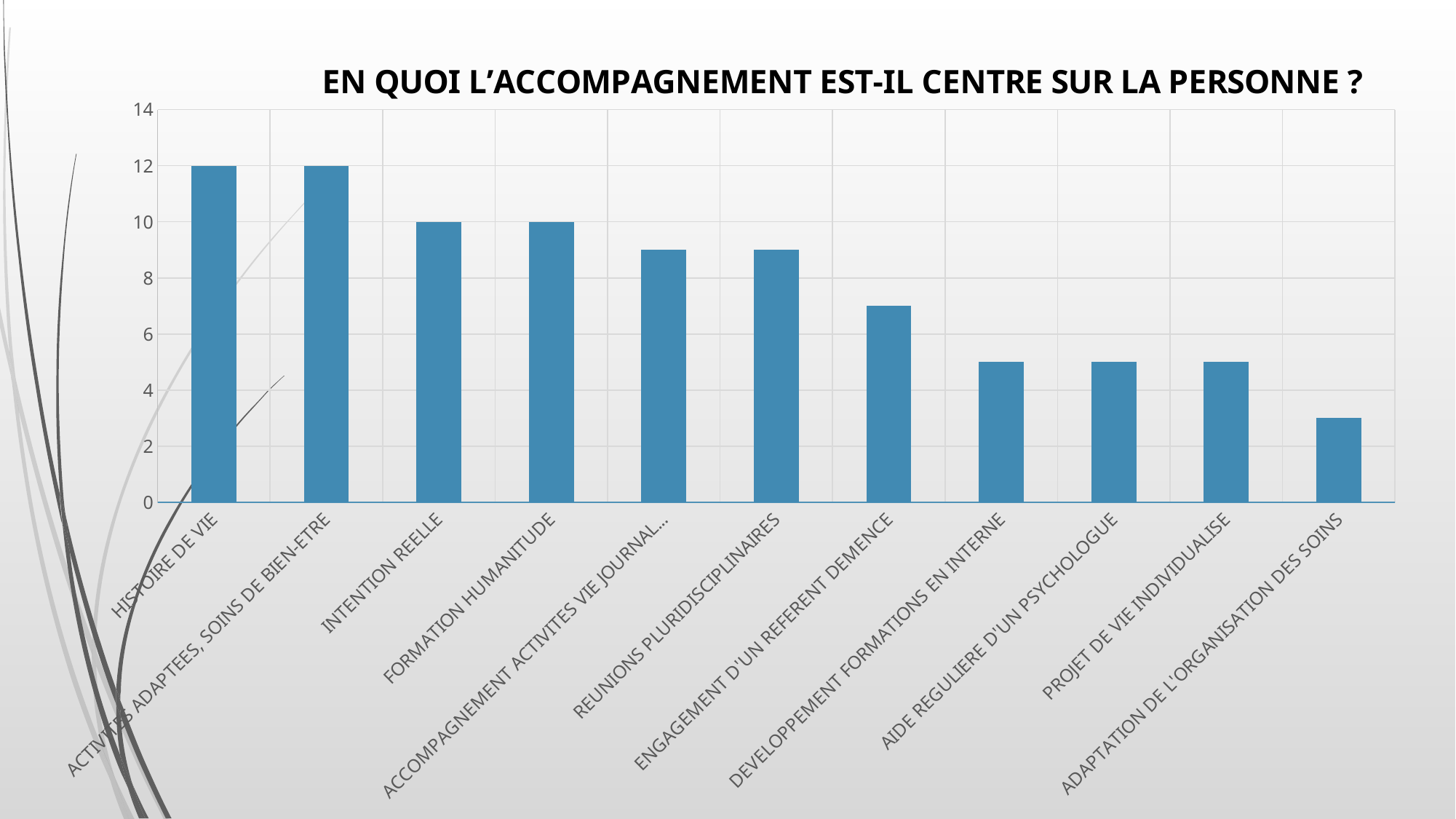
What type of chart is shown on the slide? bar chart Is the value for ENGAGEMENT D'UN REFERENT DEMENCE greater or less than 8? less Do the values generally rise or fall from left to right along the x axis? fall What is the value for FORMATION HUMANITUDE? 10 How many categories are plotted in the chart? 11 Is the value for REUNIONS PLURIDISCIPLINAIRES greater or less than 8? greater What is the value for HISTOIRE DE VIE? 12 Which is larger, the value for FORMATION HUMANITUDE or the value for ENGAGEMENT D'UN REFERENT DEMENCE? FORMATION HUMANITUDE What is the title of the chart? EN QUOI L'ACCOMPAGNEMENT EST-IL CENTRE SUR LA PERSONNE ? Which category has the lowest value? ADAPTATION DE L'ORGANISATION DES SOINS What is the value for INTENTION REELLE? 10 What is the difference between the values for HISTOIRE DE VIE and INTENTION REELLE? 2